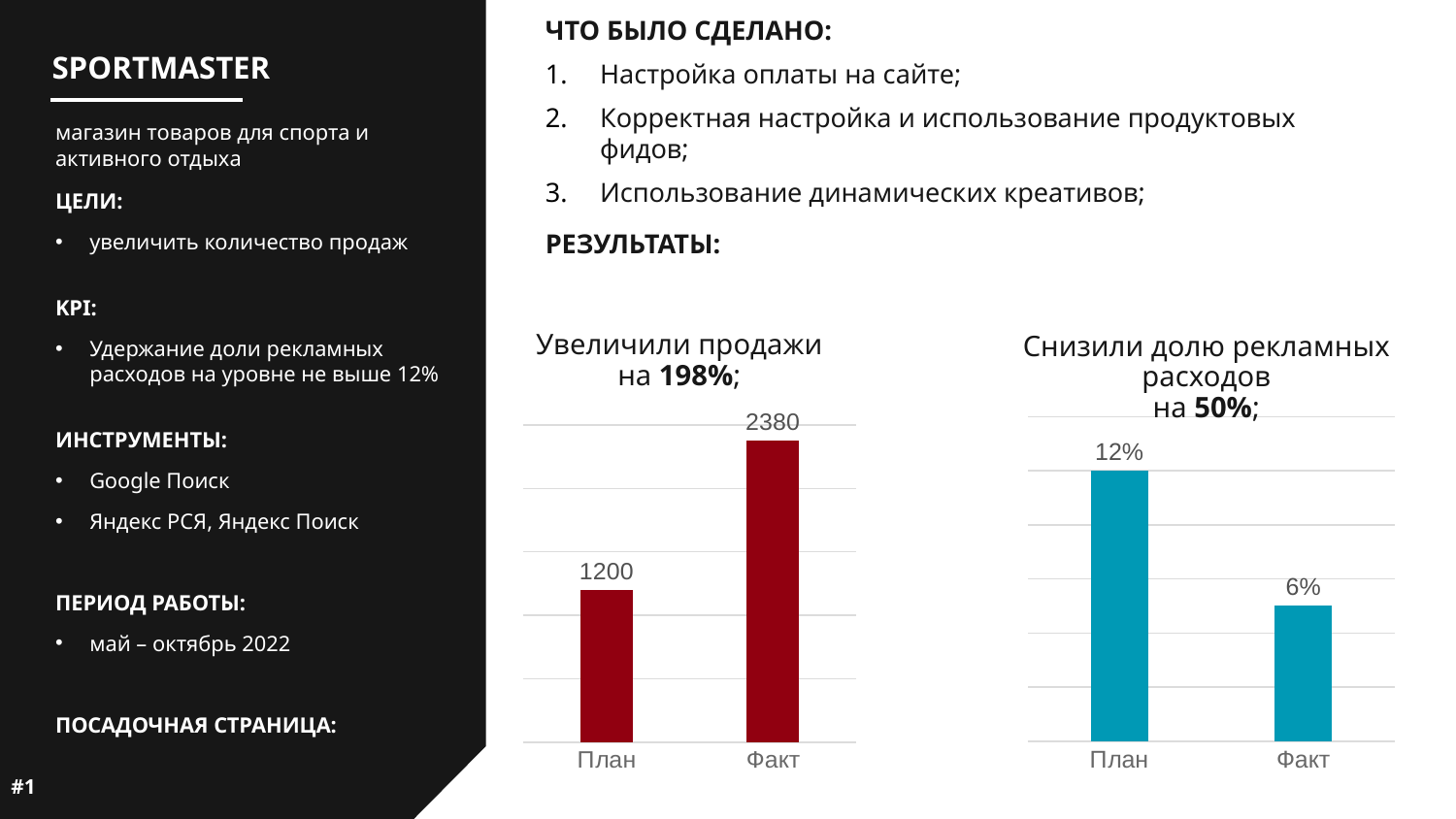
In the left chart (Увеличили продажи на 198%), which category has the higher value? Факт What colour are the bars in the right chart (Снизили долю рекламных расходов на 50%)? Blue (teal) In the left chart (Увеличили продажи на 198%), what is the value for План? 1200 In the right chart (Снизили долю рекламных расходов на 50%), what is the difference between План and Факт? 6% In the left chart (Увеличили продажи на 198%), what is the difference between Факт and План? 1180 What type of chart is the left chart (Увеличили продажи на 198%)? Bar chart In the right chart (Снизили долю рекламных расходов на 50%), do the values rise or fall from План to Факт? Fall In the right chart (Снизили долю рекламных расходов на 50%), what is the value for Факт? 6% In the left chart (Увеличили продажи на 198%), what is the value for Факт? 2380 In the right chart (Снизили долю рекламных расходов на 50%), what is the value for План? 12% In the left chart (Увеличили продажи на 198%), how many bars are plotted? 2 In the right chart (Снизили долю рекламных расходов на 50%), which category has the lower value? Факт